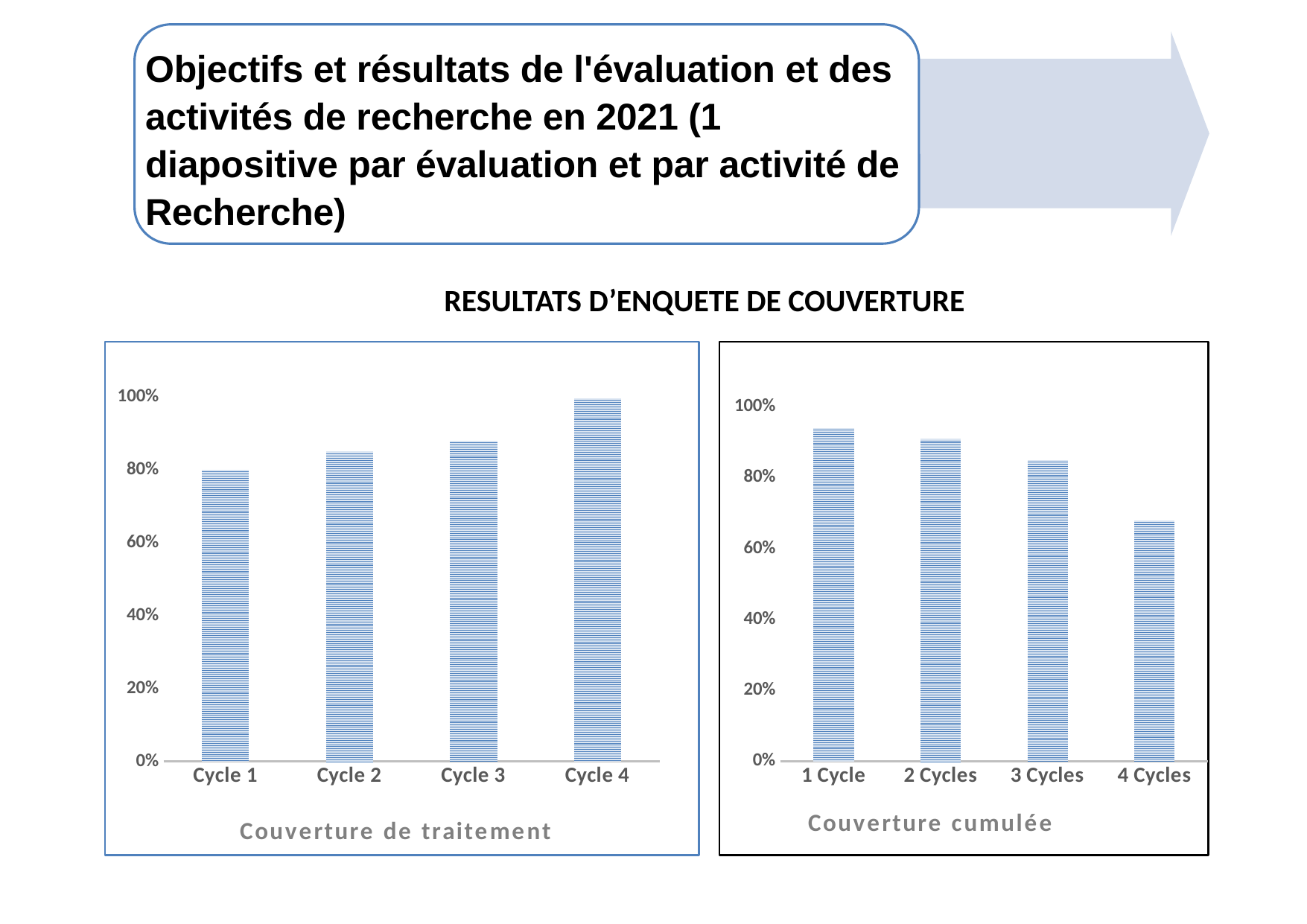
In the 'Couverture cumulée' chart, which category has the lowest value? 4 Cycles In the 'Couverture cumulée' chart, is the value for 4 Cycles greater or less than 80%? less In the 'Couverture de traitement' chart, which cycle has the lowest value? Cycle 1 In the 'Couverture de traitement' chart, which cycle has the highest value? Cycle 4 In the 'Couverture de traitement' chart, do the values rise or fall from Cycle 1 to Cycle 4? rise What kind of chart is the 'Couverture de traitement' chart? bar chart In the 'Couverture de traitement' chart, is the value for Cycle 3 greater or less than 80%? greater How many categories are shown in the 'Couverture de traitement' chart? 4 In the 'Couverture cumulée' chart, do the values rise or fall from 1 Cycle to 4 Cycles? fall In the 'Couverture cumulée' chart, which category has the highest value? 1 Cycle In the 'Couverture de traitement' chart, is the value for Cycle 2 greater or less than 100%? less What is the title shown above the two charts? RESULTATS D’ENQUETE DE COUVERTURE